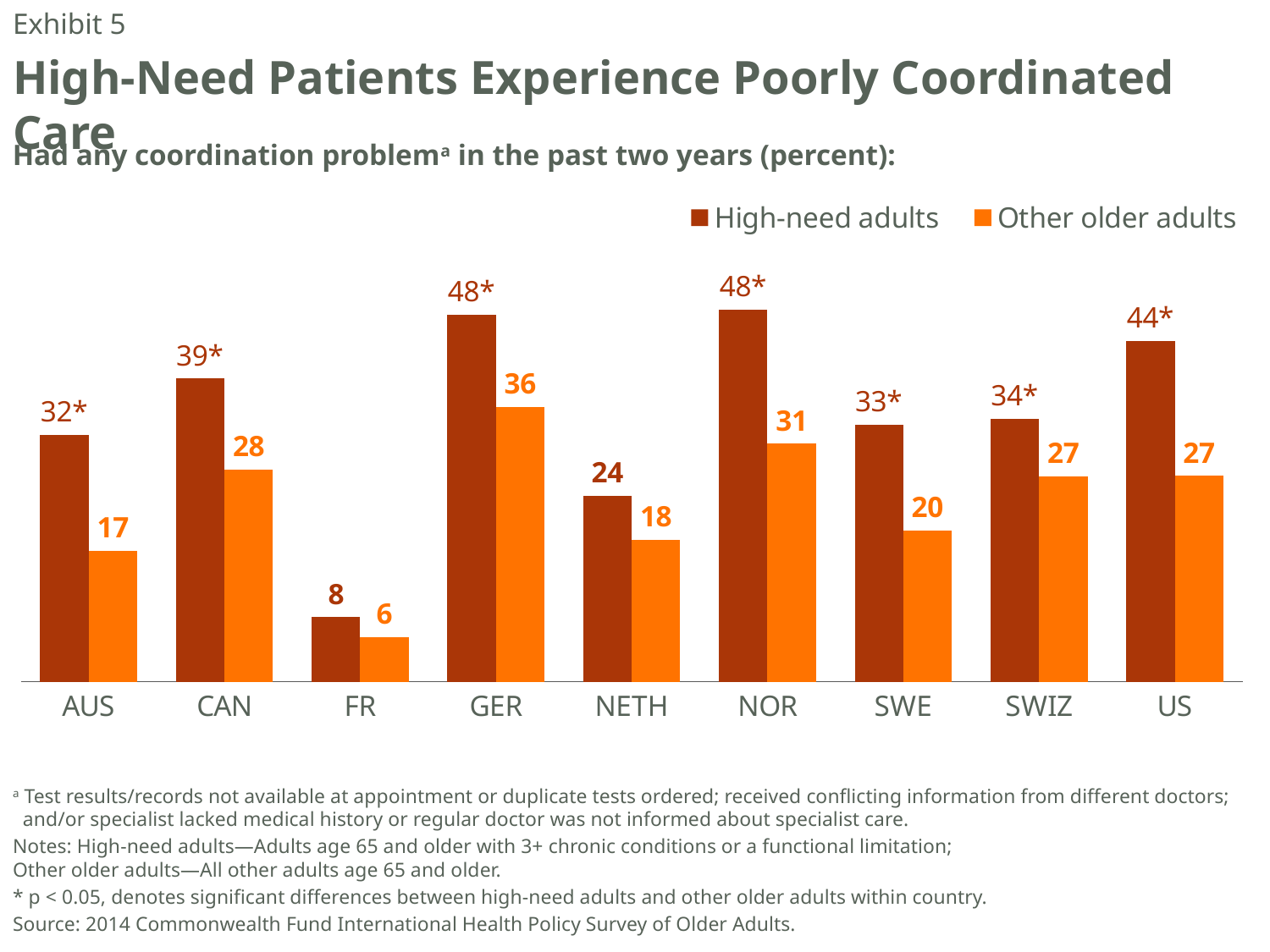
What is the value for Other older adults in NOR? 31 Which country has the lowest value for High-need adults? FR What is the difference between High-need adults and Other older adults in US? 17 What is the value for High-need adults in CAN? 39* What is the value for High-need adults in NETH? 24 How many series does the legend list? 2 Which series is shown in the lighter orange colour? Other older adults What is the difference between High-need adults and Other older adults in AUS? 15 How many countries are shown on the x axis? 9 Which is larger: the Other older adults value for GER or the Other older adults value for NOR? GER What kind of chart is shown on the slide? Bar chart Which country has the highest value for Other older adults? GER